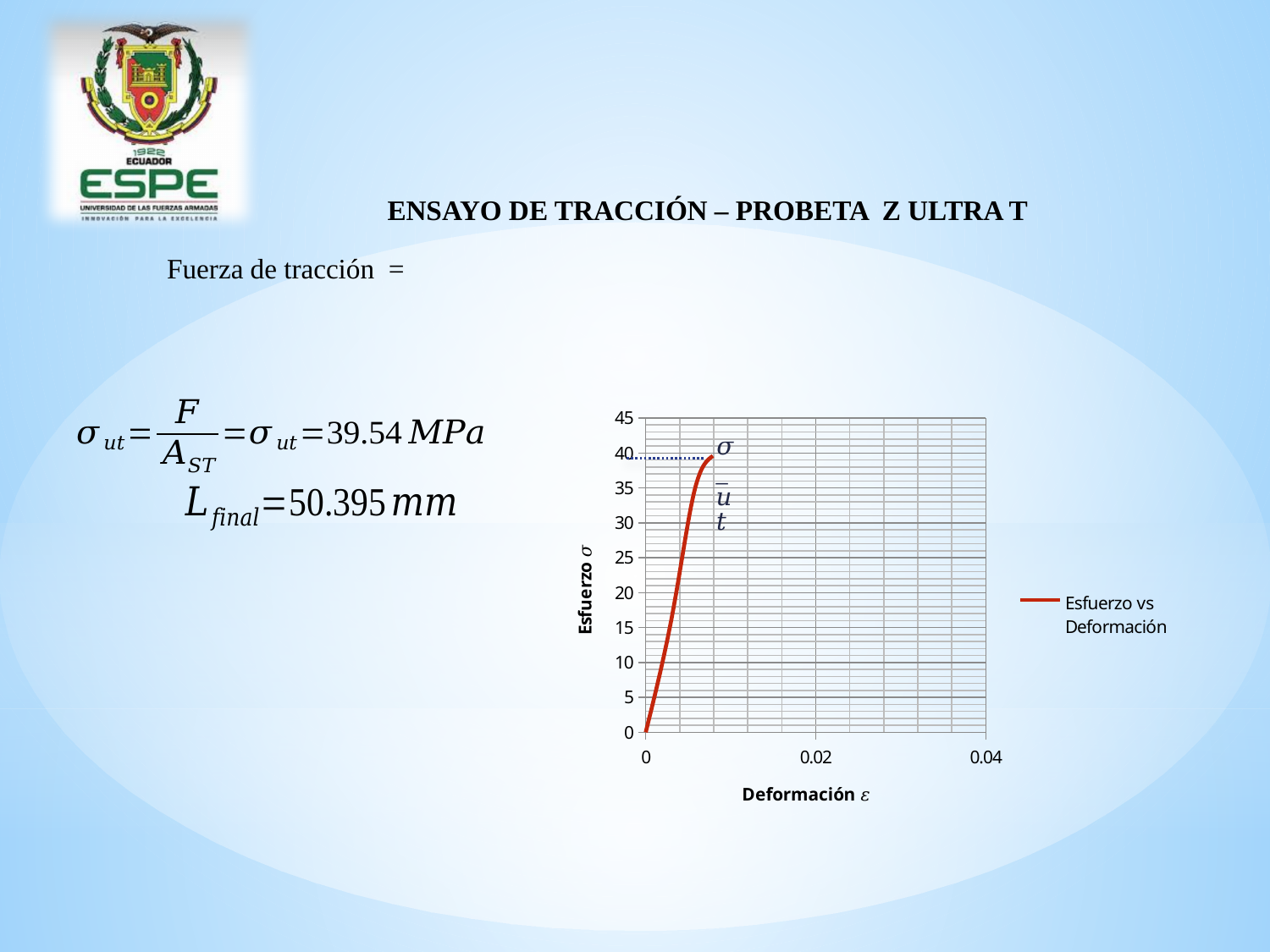
Is the highest stress value reached by the curve greater or less than 35? greater What is the title of the vertical axis of the chart? Esfuerzo σ What kind of chart is shown on the slide? line chart Is the stress value at the start of the curve greater or less than 5? less Does the plotted stress (Esfuerzo) rise or fall as the strain (Deformación) increases along the x axis? rise Is the highest stress value reached by the curve greater or less than 45? less What is the name of the series shown in the chart legend? Esfuerzo vs Deformación How many series does the chart legend list? 1